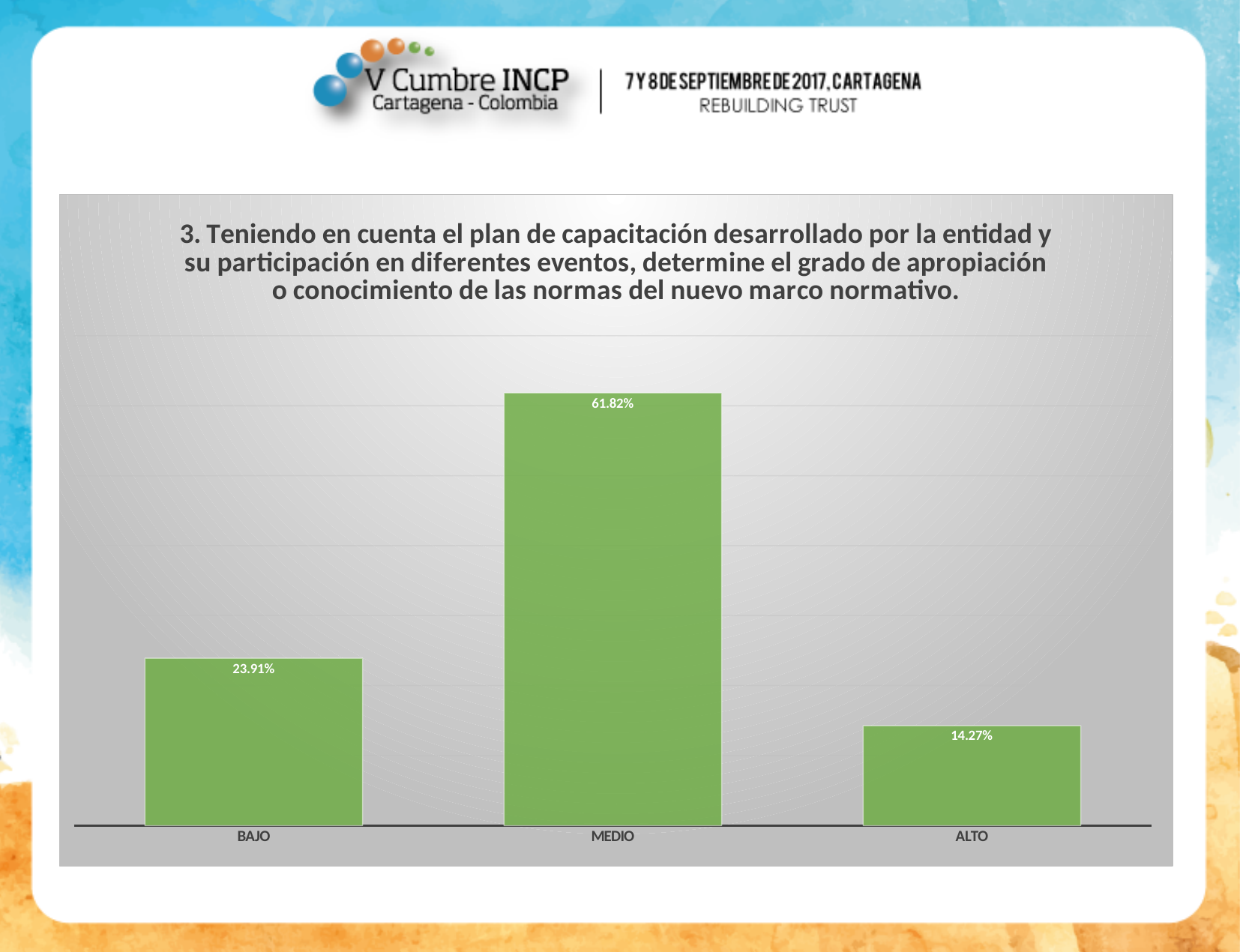
How many categories are shown on the x axis? 3 What is the label of the category in the middle of the x axis? MEDIO What is the difference between the values for MEDIO and BAJO? 37.91% What is the value for BAJO? 23.91% Which category has the highest value? MEDIO What is the value for MEDIO? 61.82% What colour are the bars in the chart? Green What kind of chart is shown on the slide? Bar chart Which is larger, the value for BAJO or the value for ALTO? BAJO What is the value for ALTO? 14.27% What is the difference between the values for BAJO and ALTO? 9.64% Which category has the lowest value? ALTO